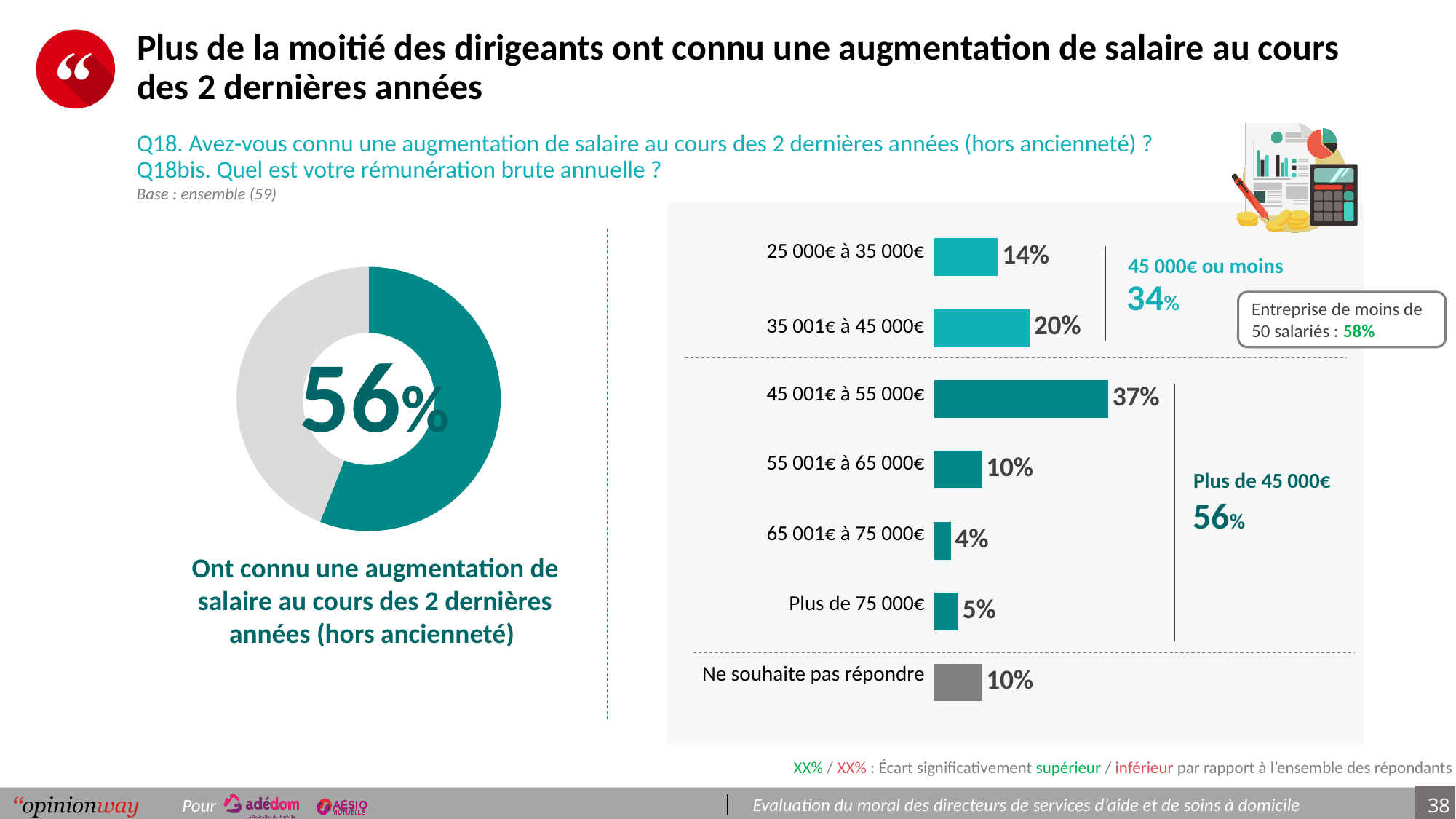
On the donut chart on the left, what percentage of respondents had a salary increase over the last 2 years? 56% On the bar chart on the right, what is the value for '25 000€ à 35 000€'? 14% On the bar chart on the right, which is larger: 'Plus de 75 000€' or '65 001€ à 75 000€'? Plus de 75 000€ On the bar chart on the right, what is the value for 'Ne souhaite pas répondre'? 10% How many categories are shown on the bar chart on the right? 7 On the bar chart on the right, what is the value for '45 001€ à 55 000€'? 37% On the bar chart on the right, what is the difference between '35 001€ à 45 000€' and '25 000€ à 35 000€'? 6% What kind of chart is shown on the right of the slide? Bar chart On the bar chart on the right, which salary bracket has the highest value? 45 001€ à 55 000€ On the bar chart on the right, which category has the lowest value? 65 001€ à 75 000€ On the bar chart on the right, what is the combined share for 'Plus de 45 000€' shown next to the bars? 56% What kind of chart is shown on the left of the slide? Donut (pie) chart